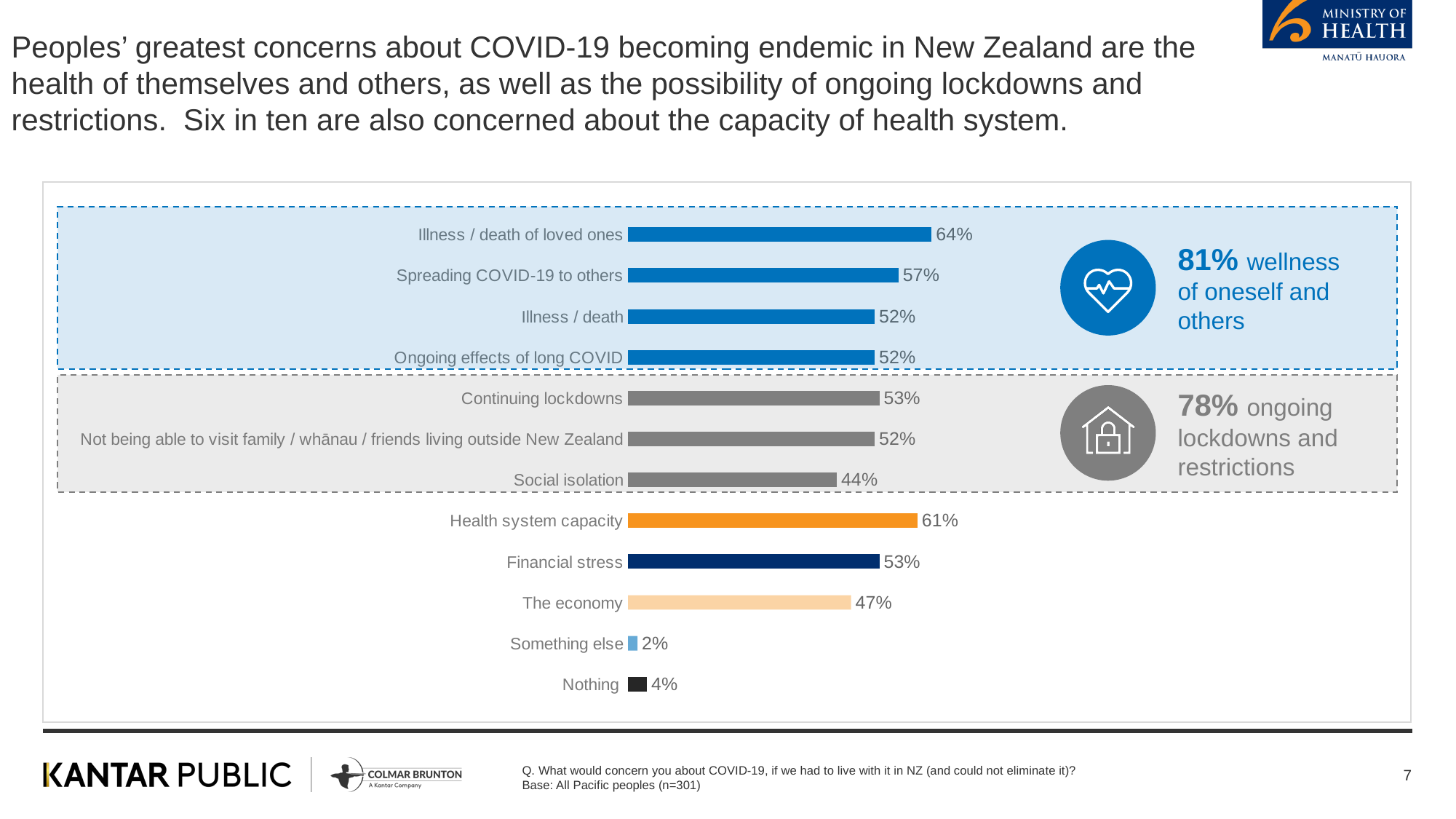
Which category has the lowest percentage? Something else What percentage is shown next to the heart icon for wellness of oneself and others? 81% What percentage of respondents are concerned about illness / death of loved ones? 64% What is the difference between Illness / death of loved ones and Spreading COVID-19 to others? 7% What percentage is shown for ongoing lockdowns and restrictions in the grey box? 78% Which concern has the highest percentage? Illness / death of loved ones How many categories are shown in the bar chart? 12 What type of chart is shown on the slide? Bar chart What is the value for Health system capacity? 61% What is the value for Something else? 2% Which is larger, Financial stress or The economy? Financial stress What is the value for Social isolation? 44%